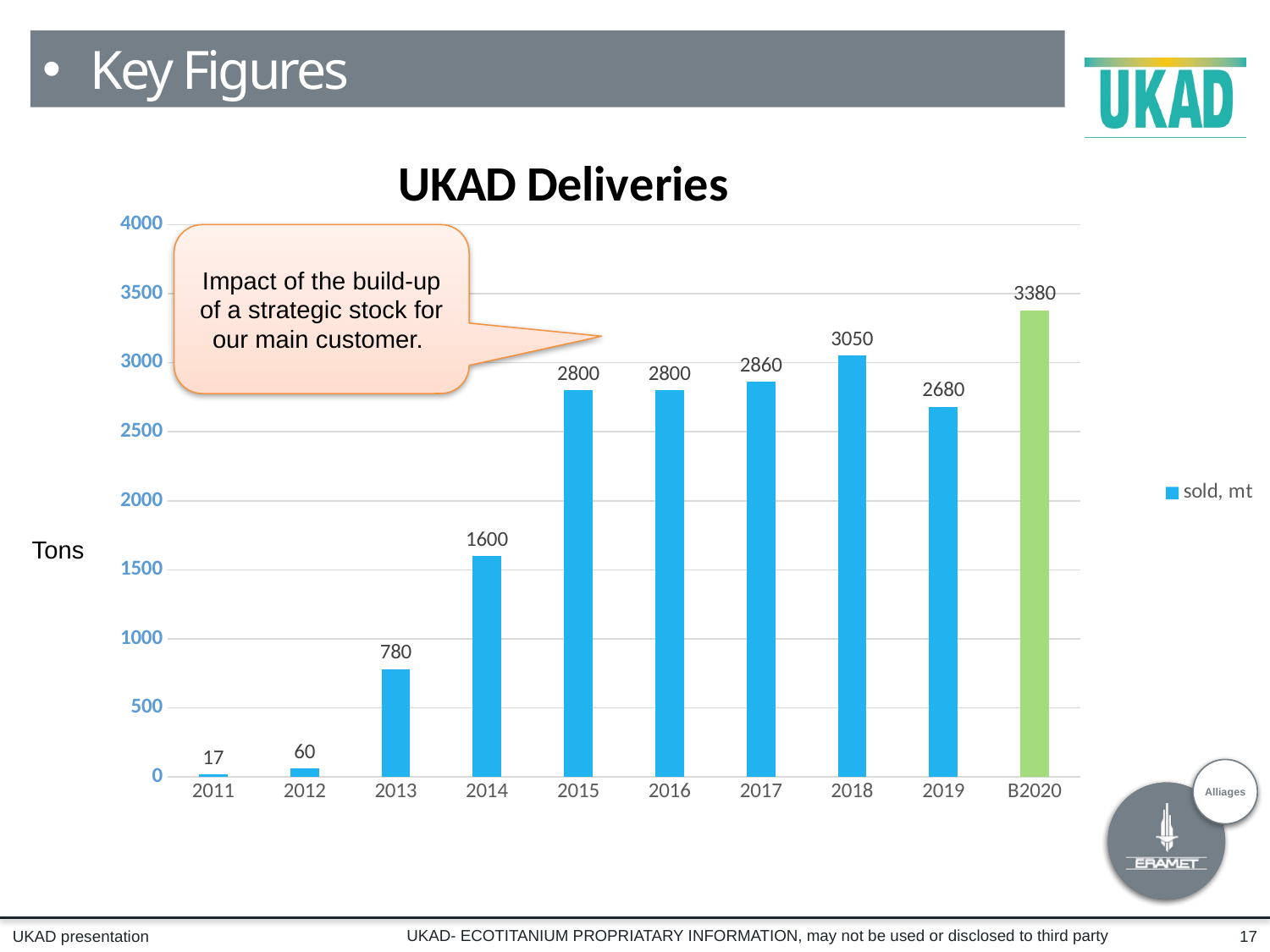
What is the value for 2013 in the UKAD Deliveries chart? 780 Which category has the highest value in the UKAD Deliveries chart? B2020 How many categories are shown on the x axis of the UKAD Deliveries chart? 10 Do the values in the UKAD Deliveries chart rise or fall from 2011 to 2018? rise What is the value for 2018 in the UKAD Deliveries chart? 3050 How many series does the legend of the UKAD Deliveries chart list? 1 What is the legend entry in the UKAD Deliveries chart? sold, mt Which is larger in the UKAD Deliveries chart, the value for 2017 or the value for 2019? 2017 What is the difference between the values for 2018 and 2019 in the UKAD Deliveries chart? 370 What is the value for B2020 in the UKAD Deliveries chart? 3380 Which category has the lowest value in the UKAD Deliveries chart? 2011 What kind of chart is the UKAD Deliveries chart? bar chart